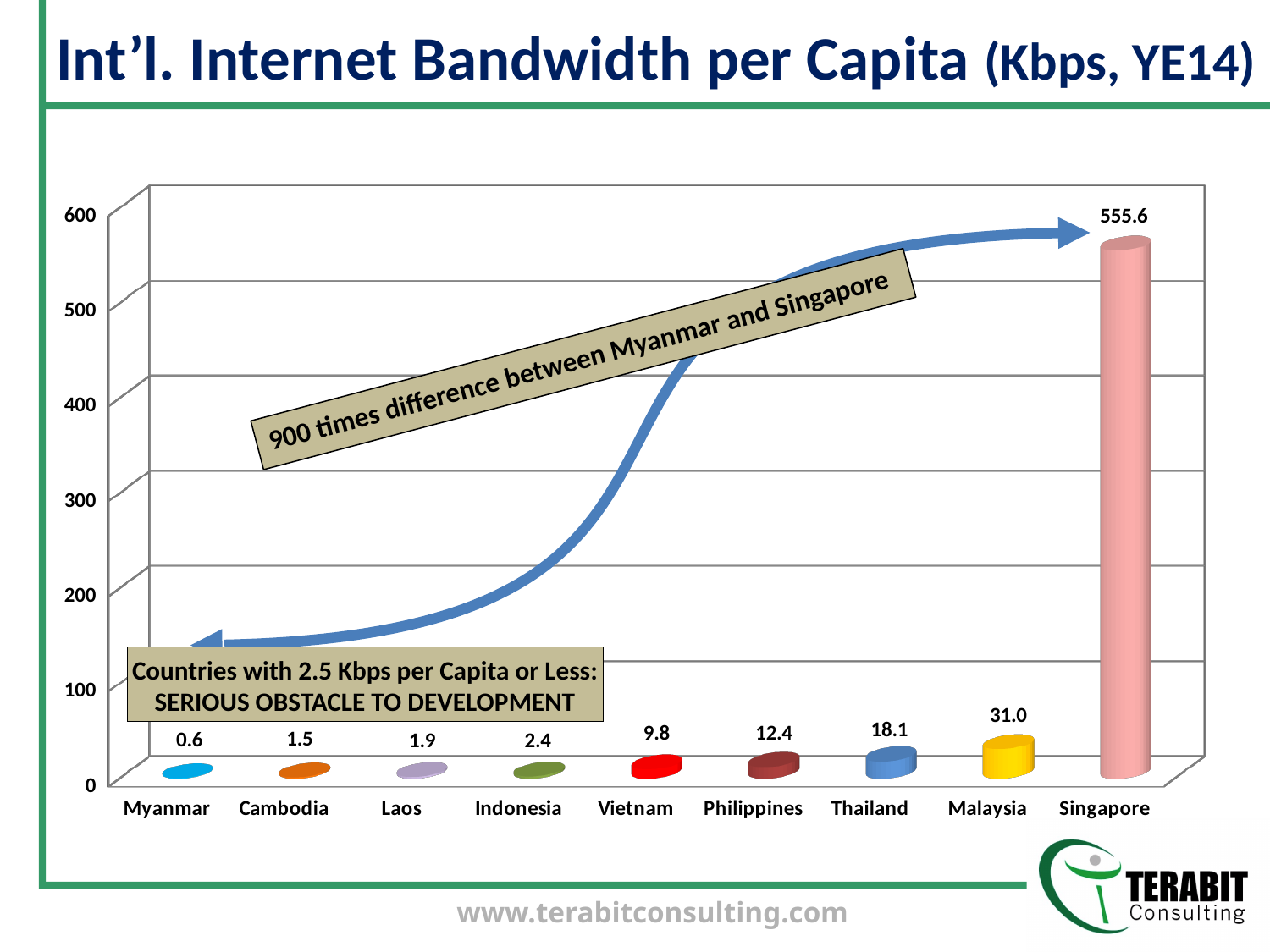
What is the international Internet bandwidth per capita for Singapore? 555.6 What is the value shown for Vietnam? 9.8 Which country has the highest bandwidth per capita? Singapore What kind of chart is this? Bar chart What is the difference between the values for Malaysia and Thailand? 12.9 How many countries are shown on the chart? 9 Which country has the lowest bandwidth per capita? Myanmar What is the value shown for Myanmar? 0.6 Which has a higher value, Philippines or Vietnam? Philippines Do the values rise or fall from Myanmar to Singapore along the x axis? Rise Is the value for Singapore greater or less than 500? greater What is the value shown for Malaysia? 31.0